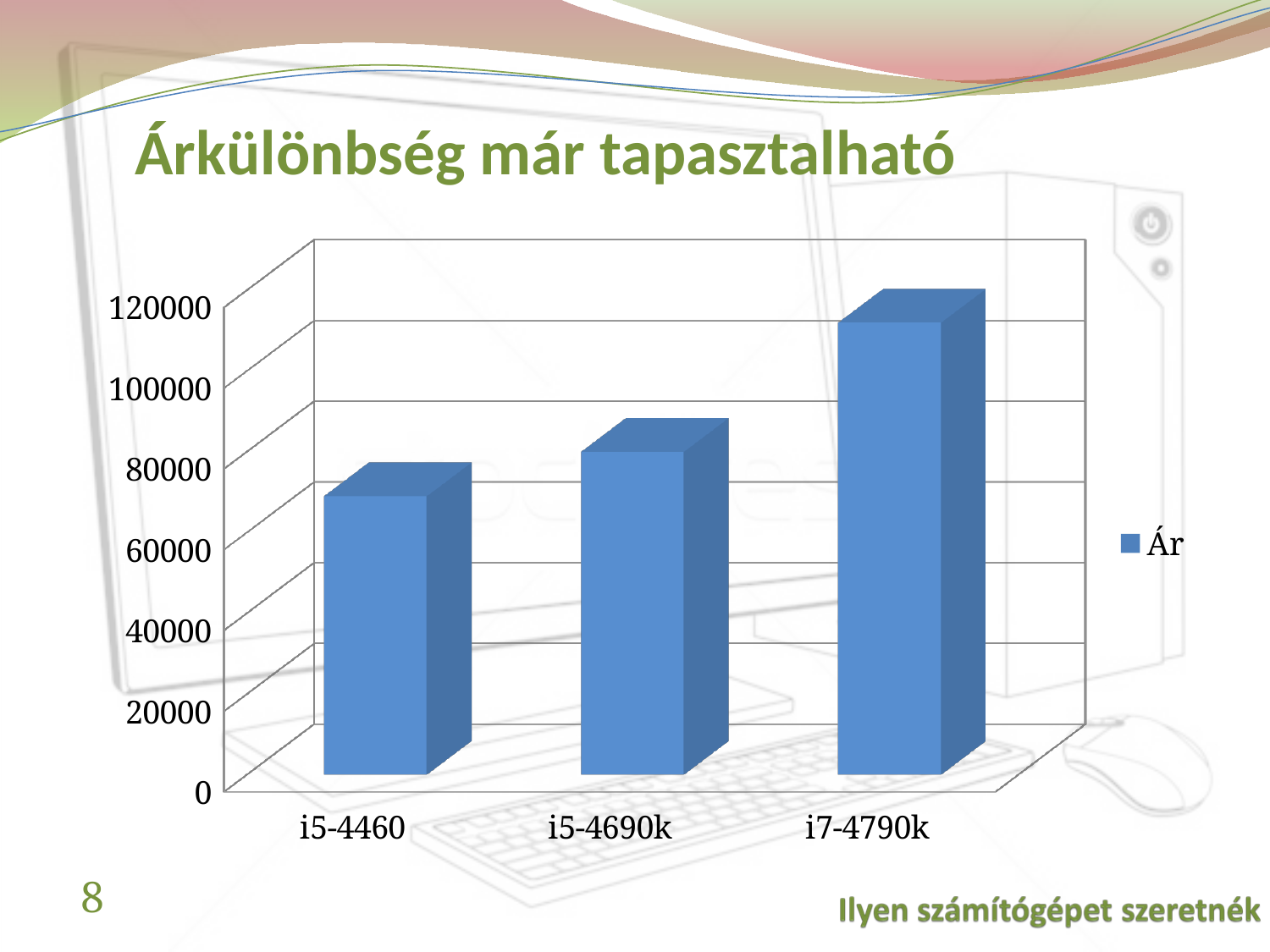
What is the name of the series listed in the chart's legend? Ár How many series does the chart's legend list? 1 Which has the larger value, i5-4690k or i5-4460? i5-4690k Which has the larger value, i7-4790k or i5-4690k? i7-4790k Is the value for i7-4790k greater or less than 100000? greater Is the value for i5-4460 greater or less than 80000? less How many categories are shown on the x axis of the chart? 3 Which category has the highest value in the chart? i7-4790k Do the values rise or fall from left to right along the x axis? rise Which category has the lowest value in the chart? i5-4460 What kind of chart is shown on the slide? bar chart Is the value for i5-4690k greater or less than 60000? greater